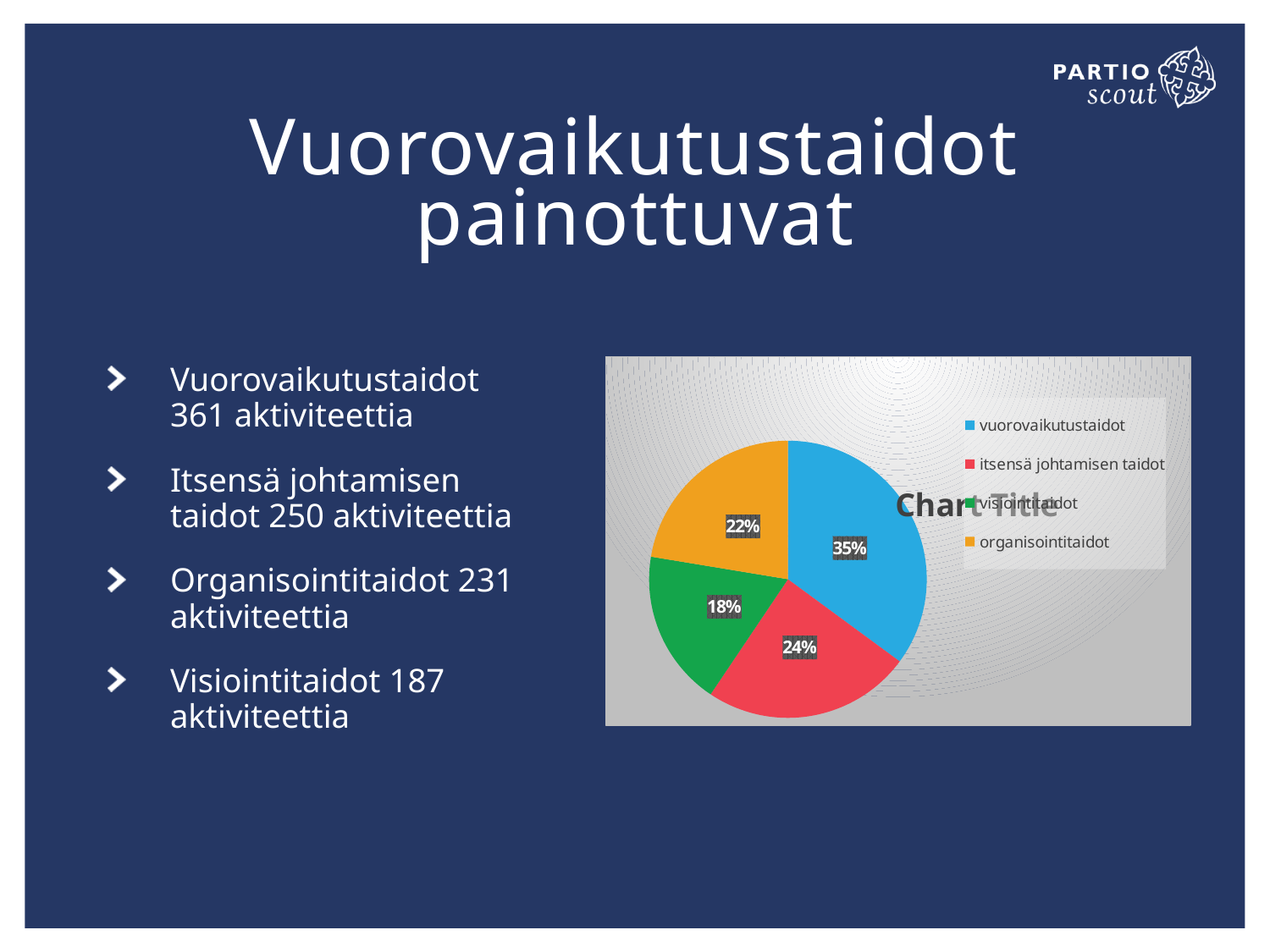
What is the difference in percentage points between vuorovaikutustaidot and visiointitaidot? 17 Which category has the smallest share of the pie? visiointitaidot What colour is the slice for organisointitaidot? Orange What is the title shown on the chart? Chart Title What type of chart is shown on the slide? Pie chart What percentage of the pie does visiointitaidot represent? 18% How many slices does the pie chart have? 4 What percentage of the pie does vuorovaikutustaidot represent? 35% Which slice is larger: itsensä johtamisen taidot or organisointitaidot? itsensä johtamisen taidot What percentage of the pie does itsensä johtamisen taidot represent? 24% Which category has the largest share of the pie? vuorovaikutustaidot What percentage of the pie does organisointitaidot represent? 22%